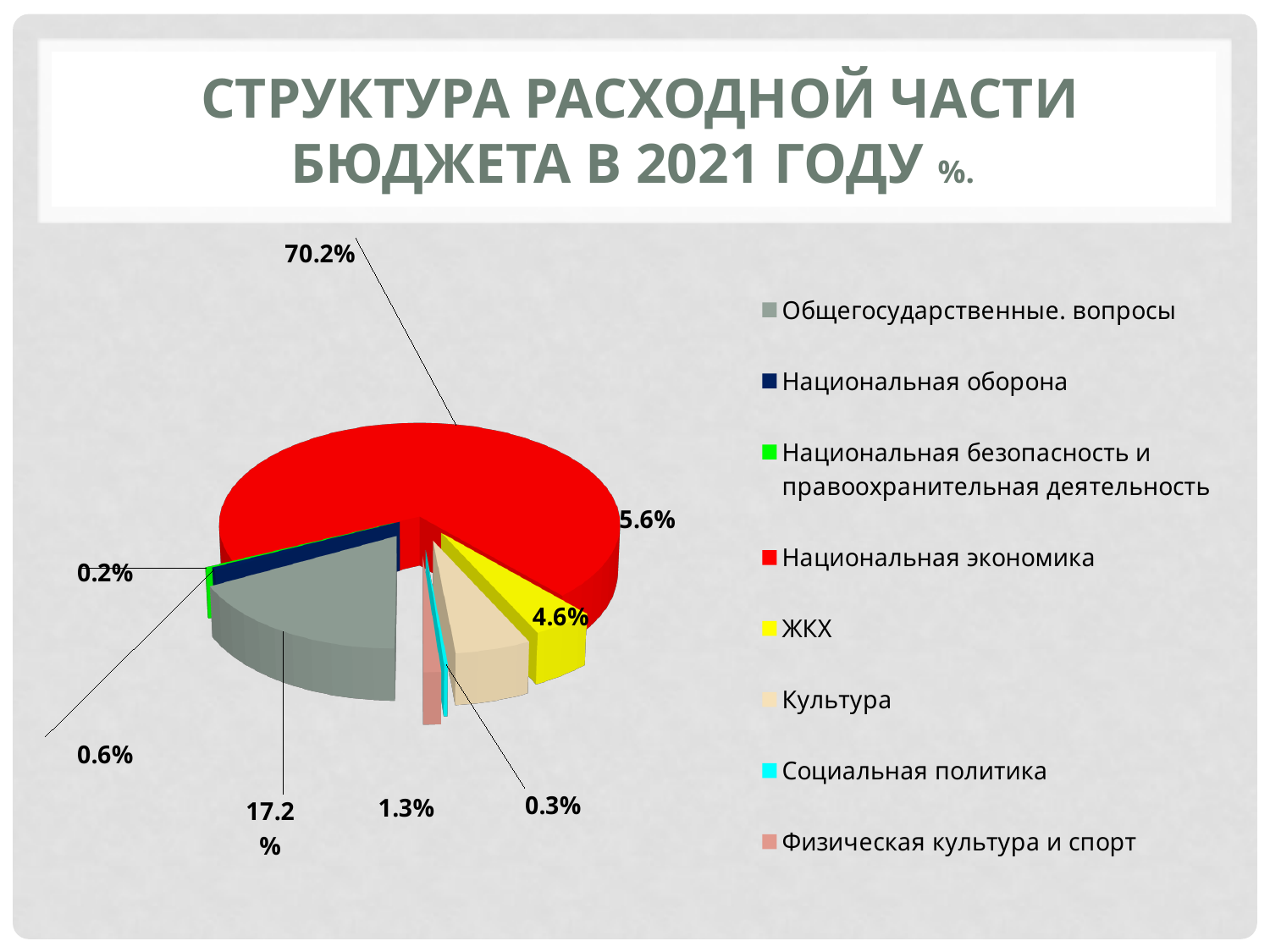
What is the share for Национальная экономика? 70.2% What is the share for Физическая культура и спорт? 1.3% Which colour represents Национальная экономика in the chart? Red Which category has the smallest share of the pie? Национальная безопасность и правоохранительная деятельность What is the share for Национальная оборона? 0.6% What is the share for ЖКХ? 4.6% What is the share for Общегосударственные вопросы? 17.2% Which category has the largest share of the pie? Национальная экономика What is the difference between the shares of Национальная экономика and Общегосударственные вопросы? 53.0% What is the share for Социальная политика? 0.3% What kind of chart is shown on the slide? Pie chart How many categories does the legend list? 8